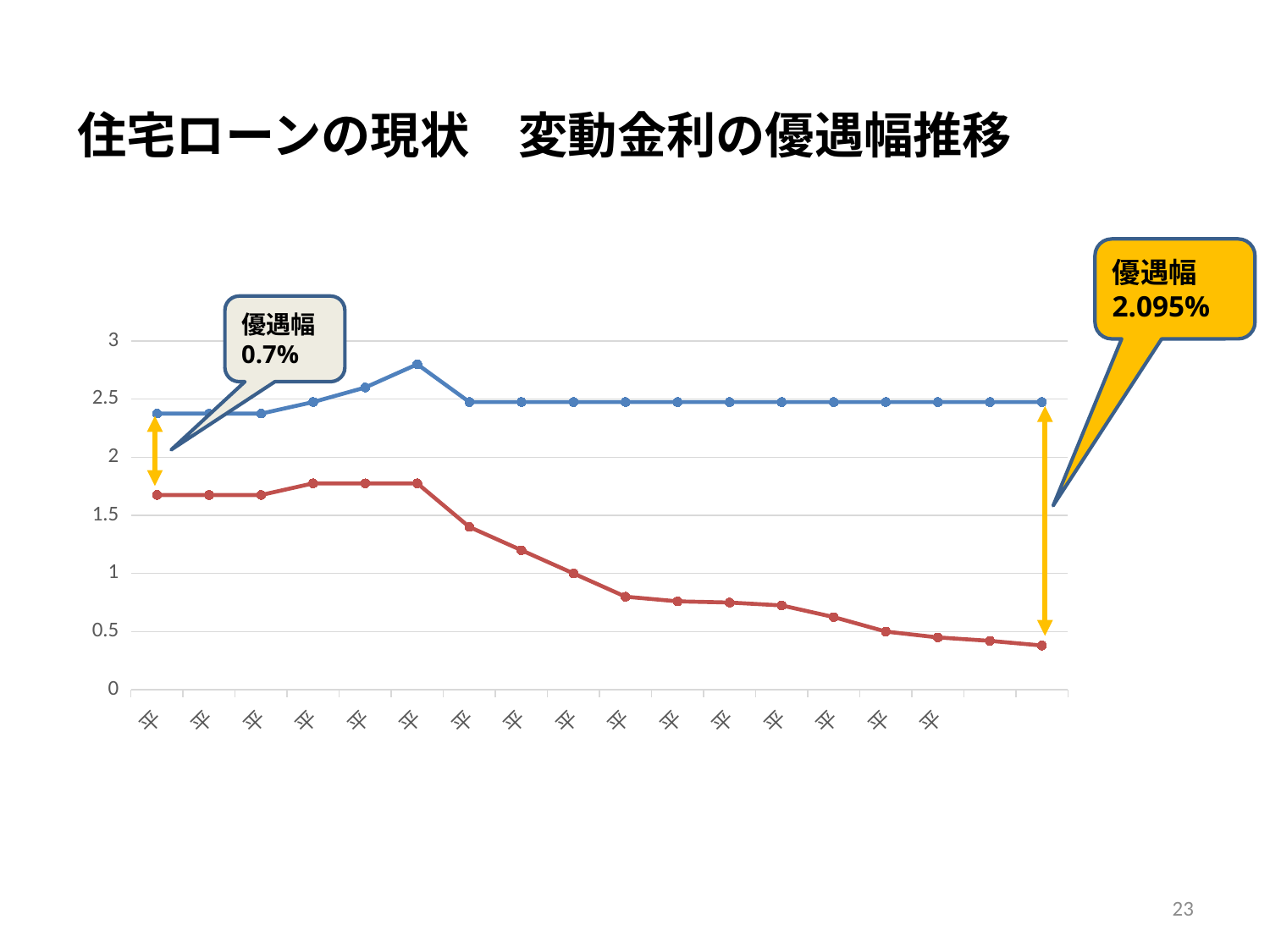
How many data points does the blue line have? 18 How many lines (series) are plotted in the chart? 2 Is the value of the last point on the red line greater or less than 0.5? less What 優遇幅 value does the callout at the right (end) of the chart show? 2.095% What is the title of the slide's chart? 住宅ローンの現状 変動金利の優遇幅推移 At the last point on the x axis, which line has the larger value, the blue line or the red line? the blue line What 優遇幅 value does the callout at the left (start) of the chart show? 0.7% What colour is the line that stays above the other line across the whole chart? blue Does the red line rise or fall overall from left to right along the x axis? fall Is the highest point on the blue line greater or less than 2.5? greater Is the value of the first point on the red line greater or less than 1.5? greater What kind of chart is shown on the slide? line chart